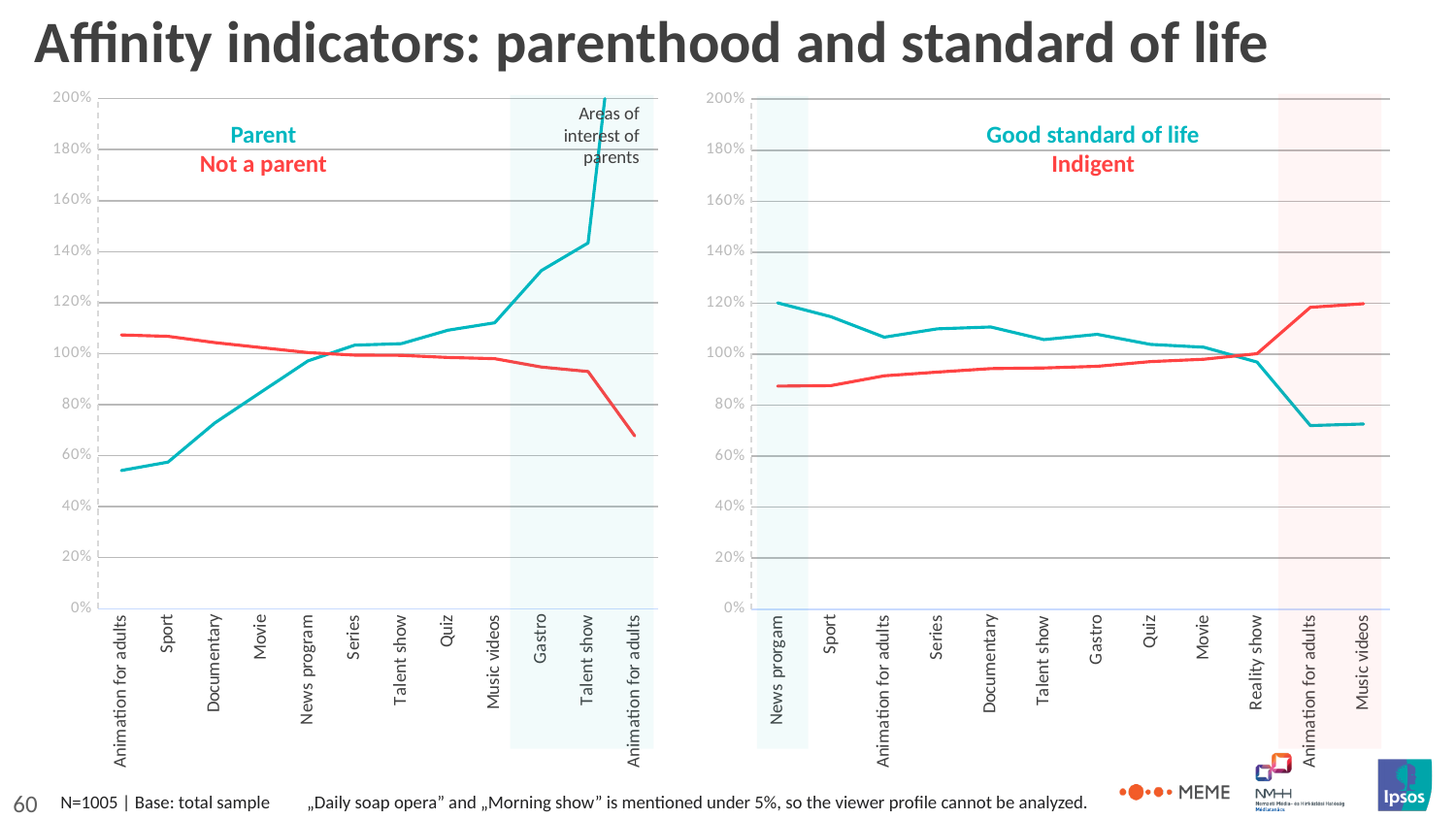
In the left chart, is the Parent value for the first category, Animation for adults, greater or less than 60%? less In the right chart, is the Indigent value for News prorgam greater or less than 100%? less In the right chart, which series has the higher value for Music videos, Good standard of life or Indigent? Indigent In the left chart, does the Parent line rise or fall from left to right along the x axis? rise How many series does the right chart (Good standard of life / Indigent) show? 2 In the left chart, is the Parent value for Gastro greater or less than 120%? greater How many categories are on the x axis of the left chart (Parent / Not a parent)? 12 In the right chart, does the Good standard of life line rise or fall from left to right along the x axis? fall What kind of chart is the left chart (Parent / Not a parent)? line chart In the left chart, which series has the higher value for Movie, Parent or Not a parent? Not a parent